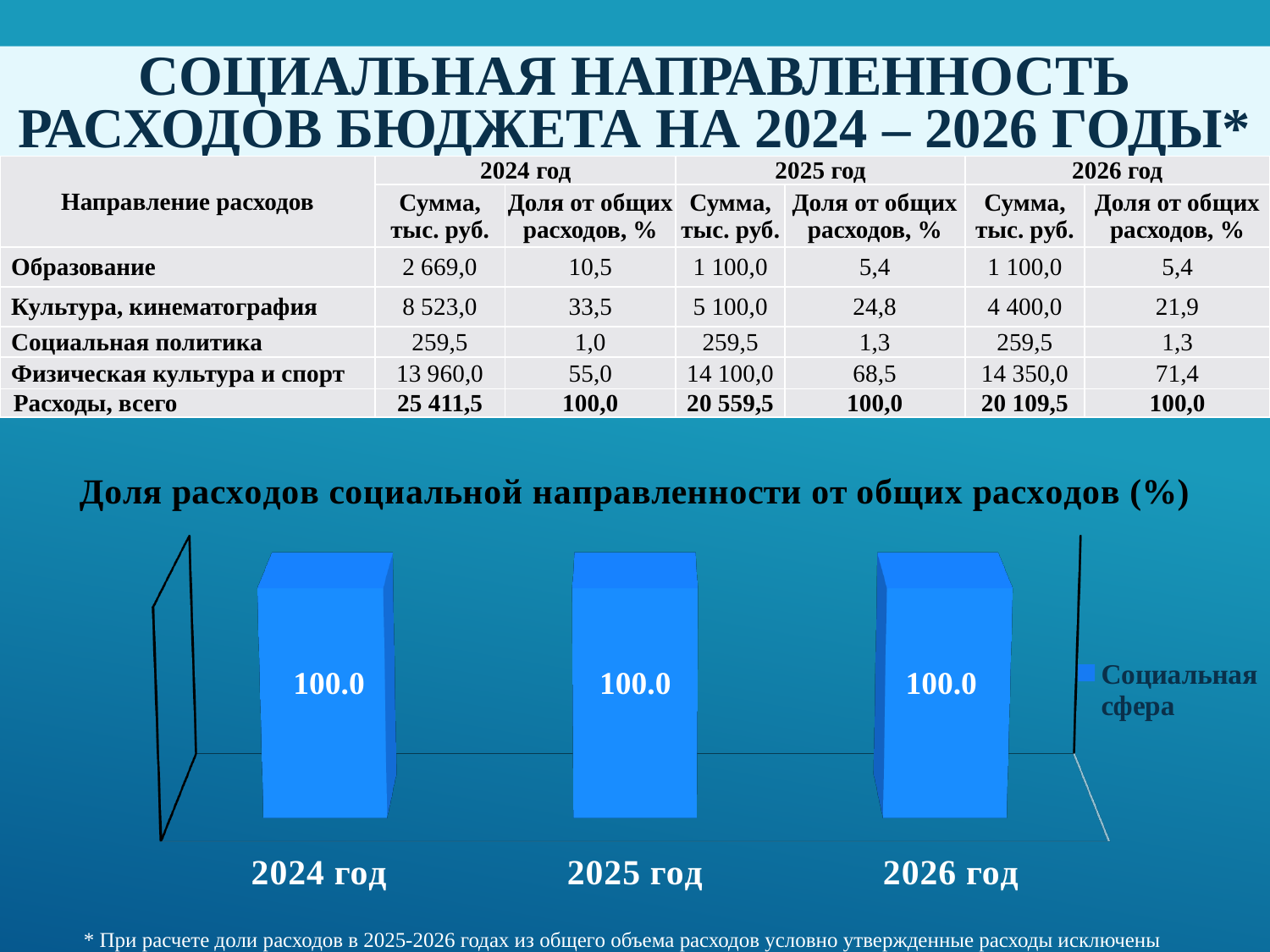
What is the name of the series shown in the chart legend? Социальная сфера What kind of chart is shown on the slide? Bar chart What is the title of the chart? Доля расходов социальной направленности от общих расходов (%) Which years are shown as categories on the x axis of the chart? 2024 год, 2025 год, 2026 год How many bars (categories) are plotted in the chart? 3 What is the difference between the values for 2024 год and 2026 год in the chart? 0.0 What is the value shown for 2026 год in the chart? 100.0 What is the value shown for 2025 год in the chart? 100.0 Do the values in the chart rise, fall, or stay the same from 2024 год to 2026 год? Stay the same What is the value shown for 2024 год in the chart? 100.0 How many series does the chart legend list? 1